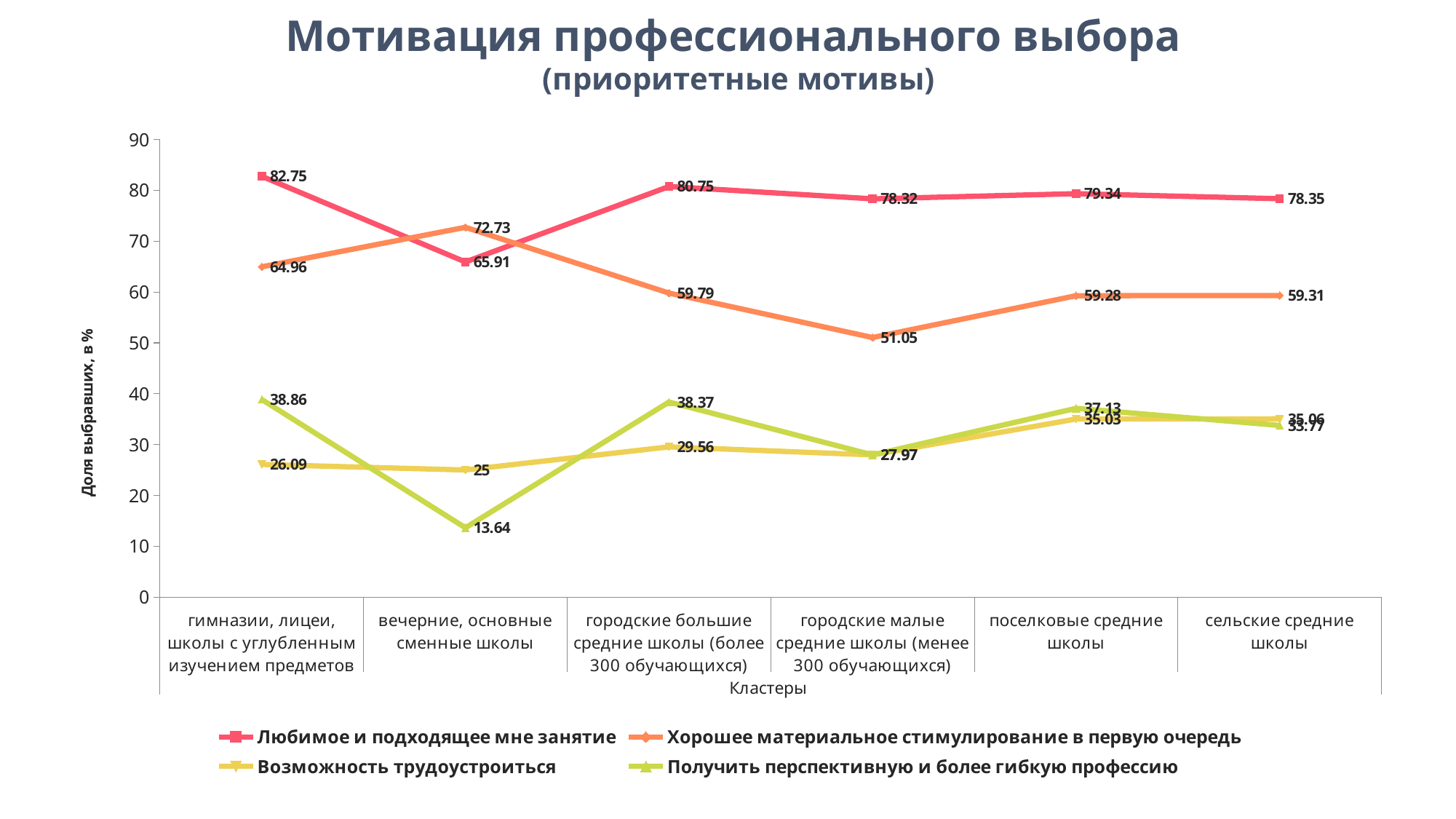
How many clusters are shown on the x axis? 6 In which cluster does «Получить перспективную и более гибкую профессию» have its lowest value? вечерние, основные сменные школы What kind of chart is shown on the slide? line chart In the «гимназии, лицеи, школы с углубленным изучением предметов» cluster, what is the difference between «Любимое и подходящее мне занятие» and «Хорошее материальное стимулирование в первую очередь»? 17.79 What is the value for «Получить перспективную и более гибкую профессию» in the «вечерние, основные сменные школы» cluster? 13.64 In the «вечерние, основные сменные школы» cluster, which is larger: «Любимое и подходящее мне занятие» or «Хорошее материальное стимулирование в первую очередь»? Хорошее материальное стимулирование в первую очередь How many series does the legend list? 4 What is the value for «Хорошее материальное стимулирование в первую очередь» in the «вечерние, основные сменные школы» cluster? 72.73 What is the value for «Возможность трудоустроиться» in the «городские большие средние школы (более 300 обучающихся)» cluster? 29.56 Is the value for «Получить перспективную и более гибкую профессию» in the «поселковые средние школы» cluster greater or less than 40? less What is the value for «Любимое и подходящее мне занятие» in the «гимназии, лицеи, школы с углубленным изучением предметов» cluster? 82.75 In which cluster does «Любимое и подходящее мне занятие» reach its highest value? гимназии, лицеи, школы с углубленным изучением предметов